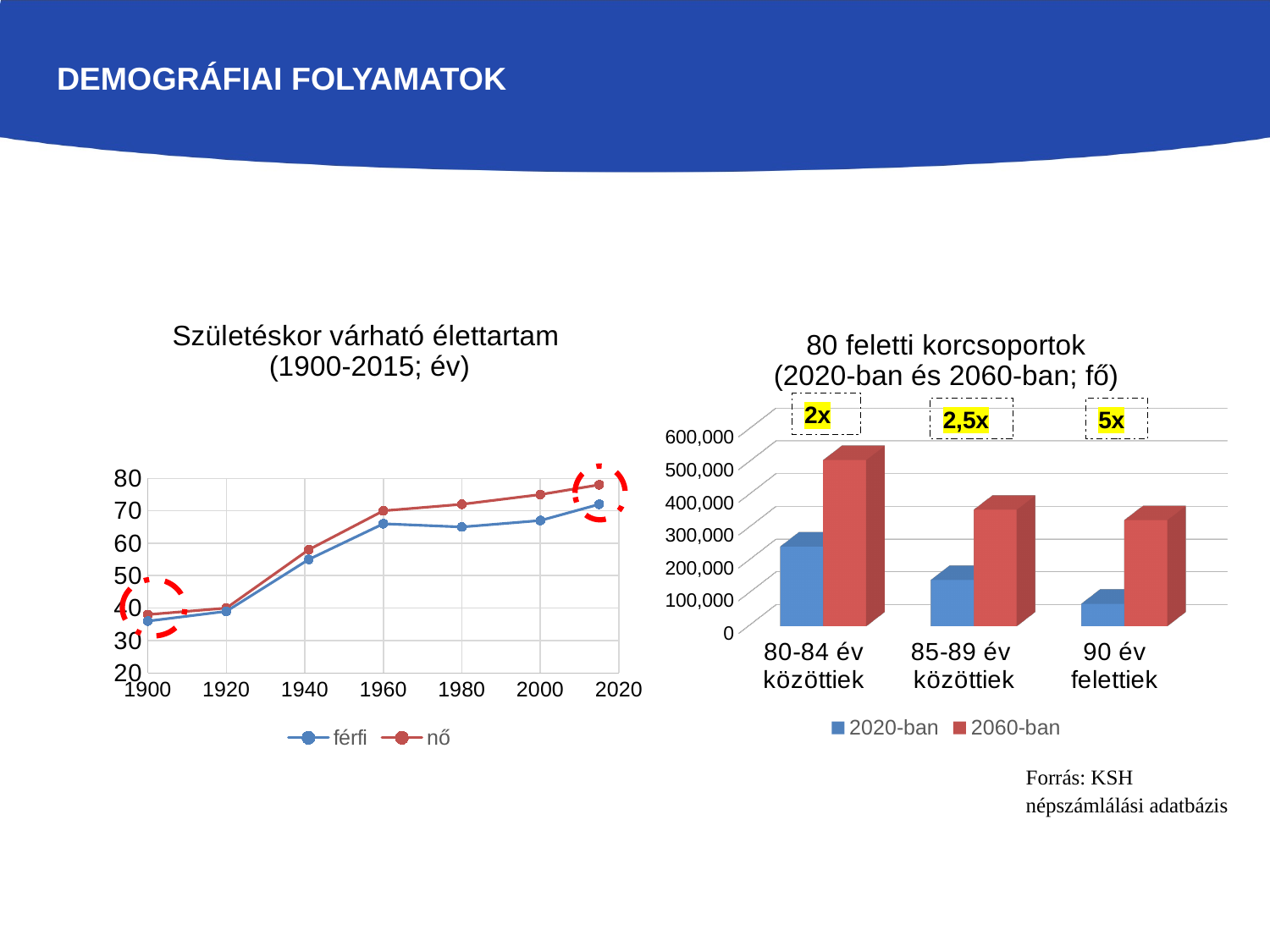
In the left chart 'Születéskor várható élettartam', which series is higher in 2015, férfi or nő? nő What kind of chart is the right chart titled '80 feletti korcsoportok (2020-ban és 2060-ban; fő)'? bar chart In the right chart '80 feletti korcsoportok', which category has the highest value for 2060-ban? 80-84 év közöttiek In the left chart 'Születéskor várható élettartam', do the values for nő generally rise or fall from 1900 to 2015? rise How many series does the legend of the left chart 'Születéskor várható élettartam' list? 2 In the right chart '80 feletti korcsoportok', what colour are the bars for the 2060-ban series? red In the right chart '80 feletti korcsoportok', which category has the lowest value for 2020-ban? 90 év felettiek What kind of chart is the left chart titled 'Születéskor várható élettartam (1900-2015; év)'? line chart In the left chart 'Születéskor várható élettartam', is the value for nő in 2015 greater or less than 70? greater How many categories are shown on the x axis of the right chart '80 feletti korcsoportok'? 3 In the left chart 'Születéskor várható élettartam', is the value for férfi in 1900 greater or less than 40? less In the right chart '80 feletti korcsoportok', is the 2060-ban value for 80-84 év közöttiek greater or less than 400,000? greater